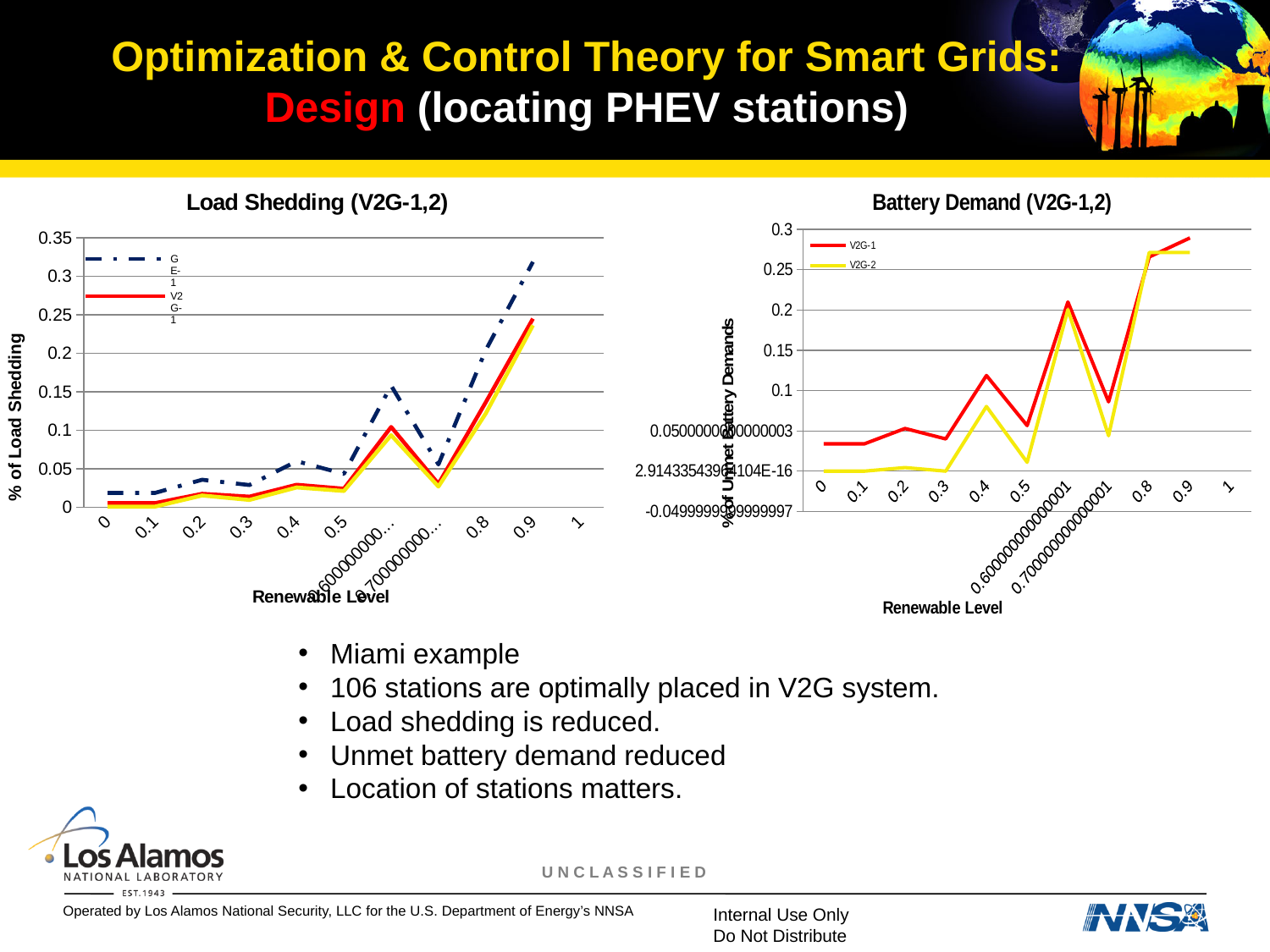
In the Battery Demand (V2G-1,2) chart, at renewable level 0.4, which series is larger, V2G-1 or V2G-2? V2G-1 In the Battery Demand (V2G-1,2) chart, is the value of V2G-2 at renewable level 0.4 greater or less than 0.1? less In the Battery Demand (V2G-1,2) chart, how many series does the legend list? 2 What is the x-axis title of the Load Shedding (V2G-1,2) chart? Renewable Level What kind of chart is the Load Shedding (V2G-1,2) chart? line chart In the Battery Demand (V2G-1,2) chart, which series does the legend list first? V2G-1 In the Load Shedding (V2G-1,2) chart, is the value of the V2G-1 series at renewable level 0.9 greater or less than 0.2? greater In the Battery Demand (V2G-1,2) chart, do the values of V2G-1 generally rise or fall as the renewable level increases from 0 to 0.9? rise In the Battery Demand (V2G-1,2) chart, at which renewable level does the V2G-1 series reach its highest value? 0.9 In the Battery Demand (V2G-1,2) chart, is the value of V2G-1 at renewable level 0.9 greater or less than 0.25? greater In the Load Shedding (V2G-1,2) chart, at renewable level 0.9, which series is larger, GE-1 or V2G-1? GE-1